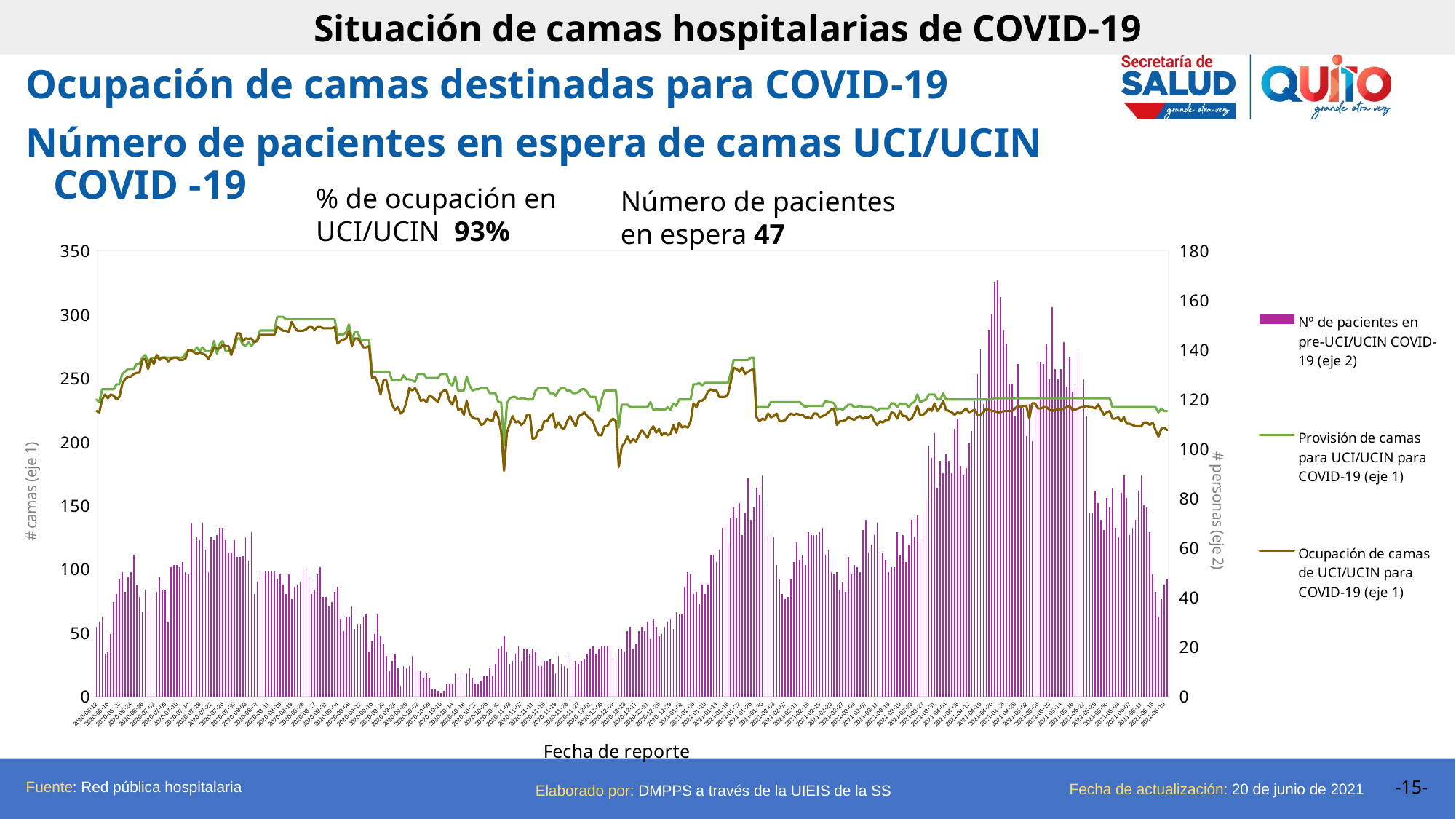
How many series does the chart legend list? 3 Around November 2020, is the 'Provisión de camas' line above or below the 'Ocupación de camas' line? above What is the maximum value shown on the left vertical axis (# camas)? 350 What kind of chart is shown on the slide? A combination chart with bars and lines Which series is drawn as bars in the chart? N° de pacientes en pre-UCI/UCIN COVID-19 (eje 2) Is the highest value of the 'Provisión de camas para UCI/UCIN para COVID-19' line greater or less than 250? greater Is the highest bar for 'N° de pacientes en pre-UCI/UCIN COVID-19' greater or less than 140 on the right axis? greater What percentage of UCI/UCIN occupation is stated on the slide? 93% How many patients waiting (en espera) are stated on the slide? 47 What is the title of the x axis of the chart? Fecha de reporte Is the lowest value of the 'Ocupación de camas de UCI/UCIN para COVID-19' line greater or less than 200? less Does the 'Provisión de camas para UCI/UCIN para COVID-19' line rise or fall between June 2020 and August 2020? rise